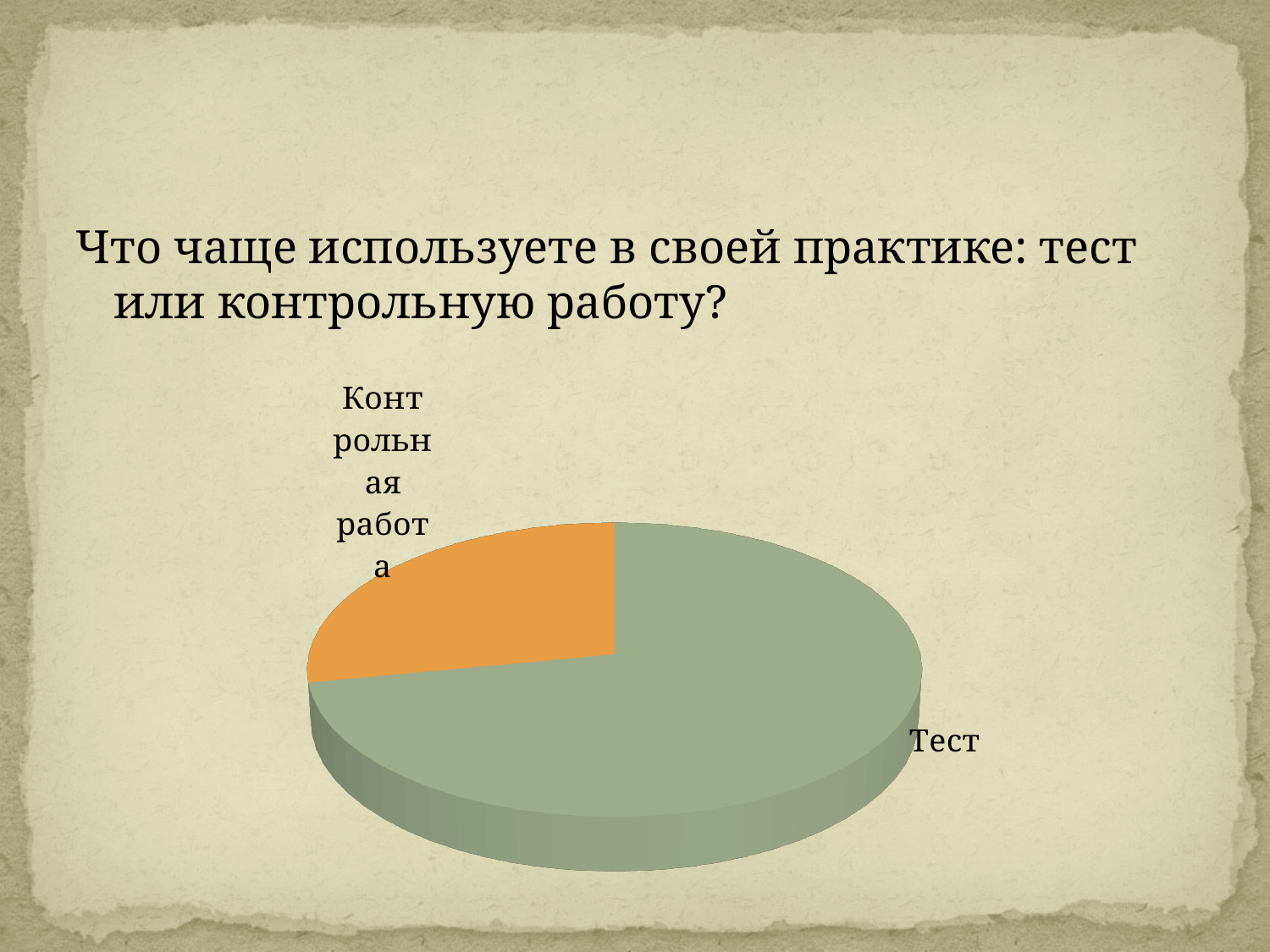
Which category has the smallest slice of the pie? Контрольная работа Which category has the largest slice of the pie? Тест What kind of chart is shown on the slide? pie chart Which slice is larger: Тест or Контрольная работа? Тест How many slices does the pie chart have? 2 What question is the chart on the slide answering? Что чаще используете в своей практике: тест или контрольную работу? What colour is the slice for Контрольная работа? orange